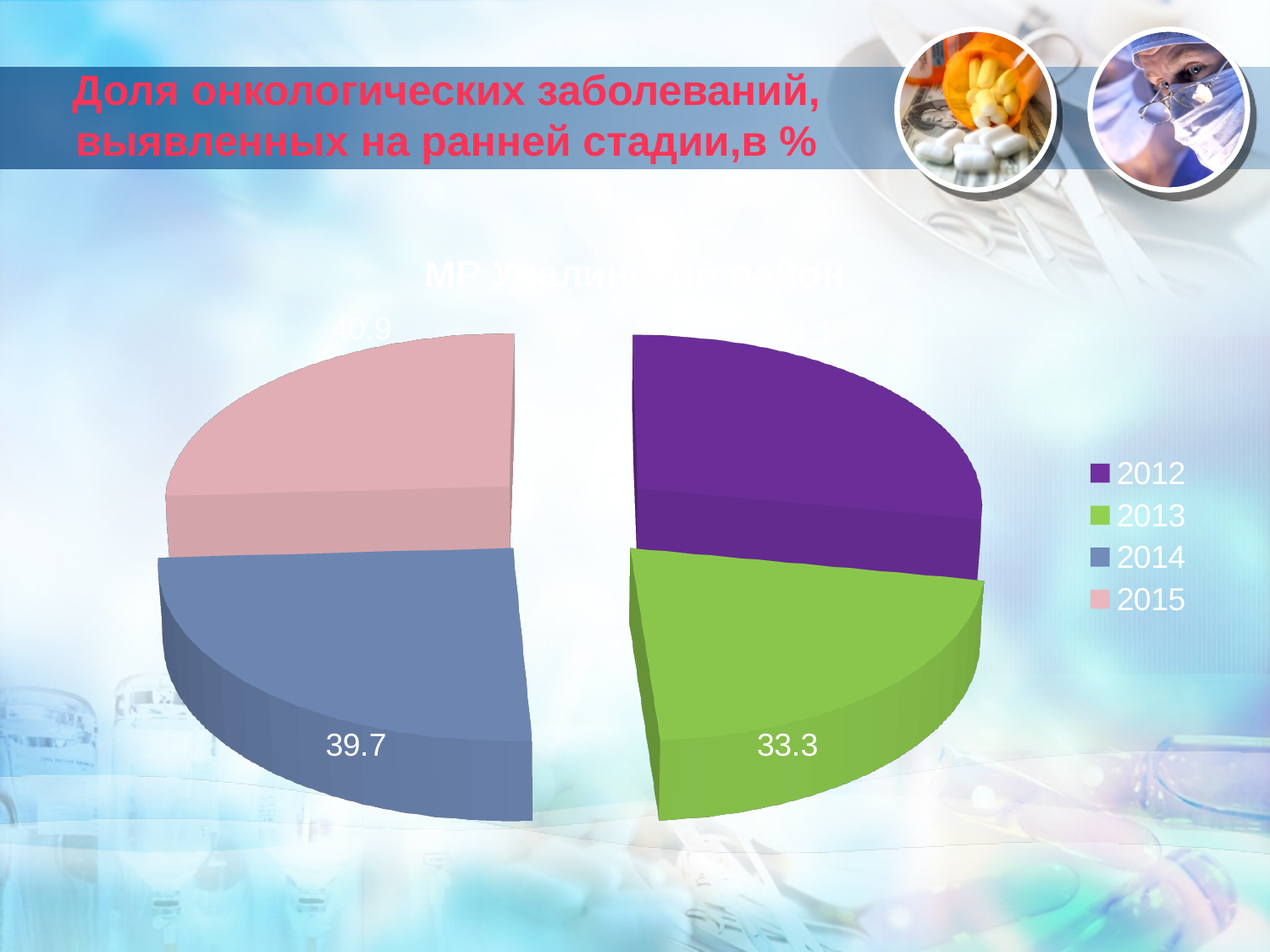
What is the difference between the values for 2014 and 2013? 6.4 How many entries does the legend list? 4 What value is shown for 2014 in the pie chart? 39.7 Which has the larger value, 2015 or 2013? 2015 What is the difference between the values for 2015 and 2013? 7.6 How many slices does the pie chart have? 4 Which has the larger value, 2014 or 2013? 2014 What kind of chart is shown on the slide? Pie chart What value is shown for 2015 in the pie chart? 40.9 What value is shown for 2013 in the pie chart? 33.3 What is the difference between the values for 2015 and 2014? 1.2 What colour is the slice for 2012 in the pie chart? Purple